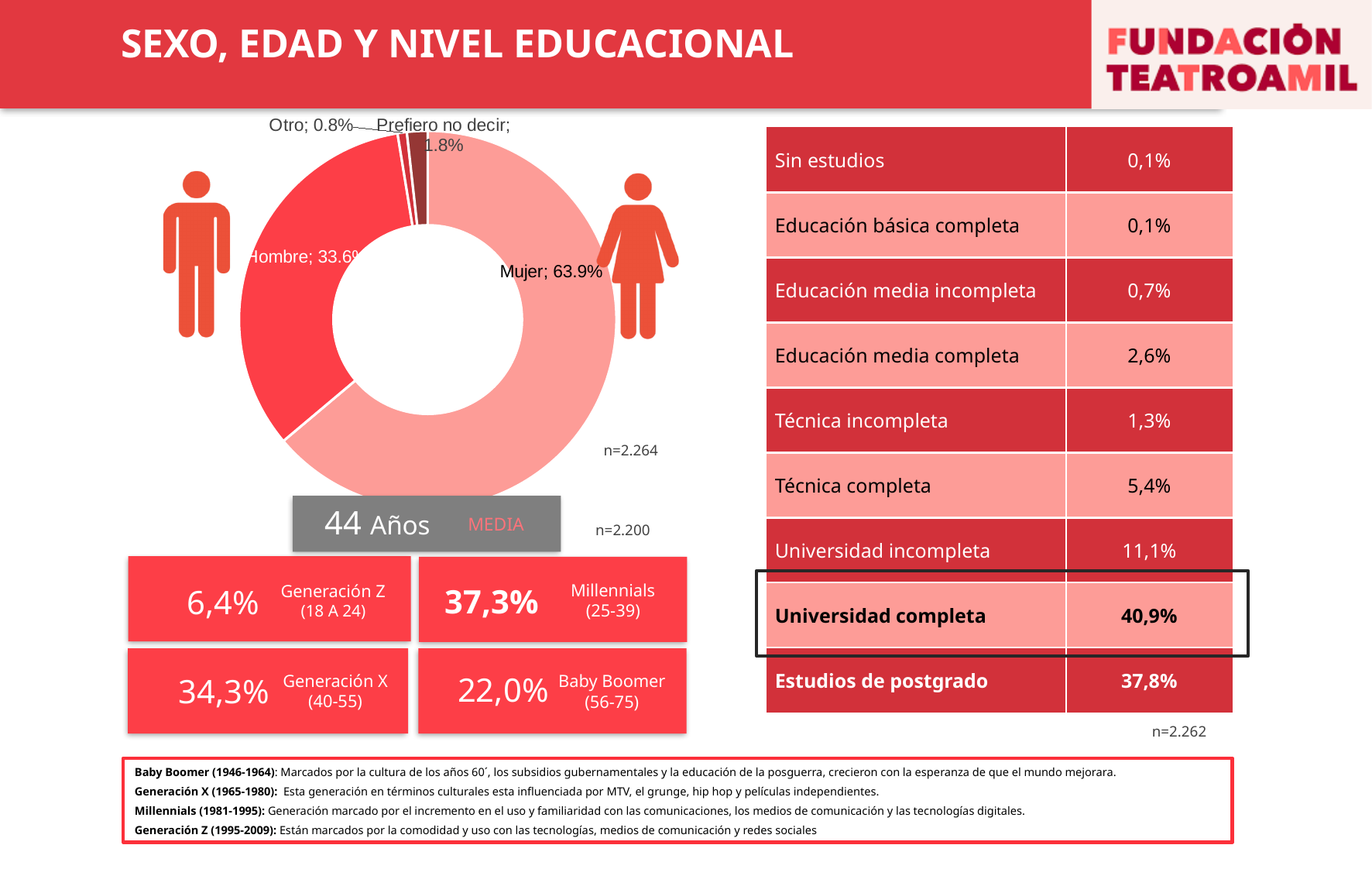
In the donut chart, what percentage is shown for Otro? 0.8% Which category has the smallest slice in the donut chart? Otro What sample size (n) is shown next to the donut chart? n=2.264 In the donut chart, which is larger, Prefiero no decir or Otro? Prefiero no decir What type of chart is used to show the sex distribution on the slide? Donut (pie) chart In the donut chart, what is the difference in percentage points between Mujer and Hombre? 30.3 In the donut chart, what percentage is shown for Hombre? 33.6% In the donut chart, what percentage is shown for Prefiero no decir? 1.8% In the donut chart, what percentage is shown for Mujer? 63.9% Which category has the largest slice in the donut chart? Mujer In the donut chart, is the value for Hombre greater or less than 50%? less How many categories are shown in the donut chart? 4